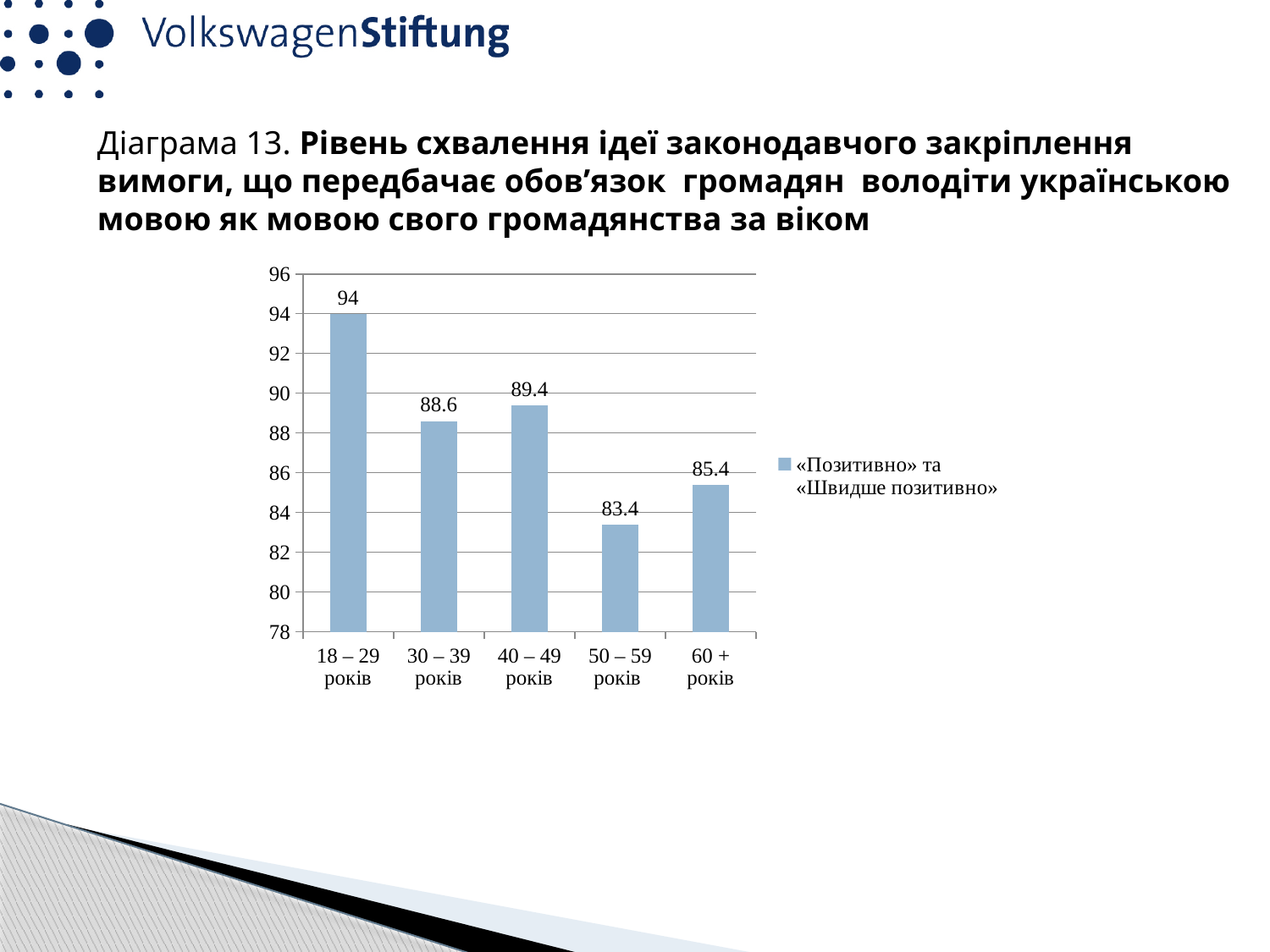
What is the value for the 50 – 59 років age group? 83.4 What is the difference between the values for 40 – 49 років and 30 – 39 років? 0.8 How many series does the legend list? 1 What is the value for the 60 + років age group? 85.4 Which is larger, the value for 30 – 39 років or the value for 60 + років? 30 – 39 років What is the value for the 18 – 29 років age group? 94 What kind of chart is shown on the slide? bar chart What is the difference between the values for 18 – 29 років and 50 – 59 років? 10.6 Is the value for 40 – 49 років greater or less than 88? greater Which age group has the lowest value? 50 – 59 років Which age group has the highest value? 18 – 29 років How many age groups are shown on the chart? 5